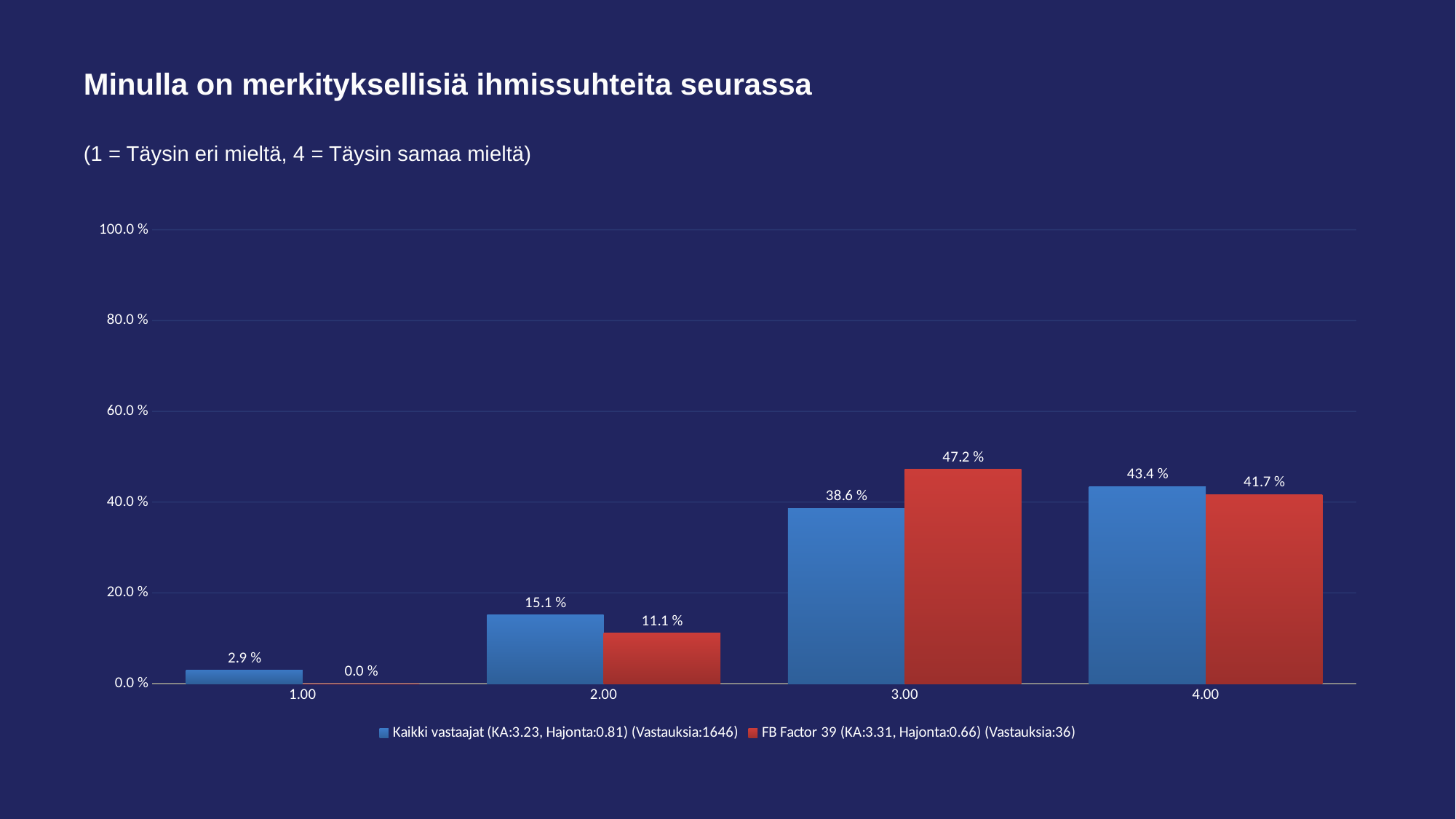
How many series does the legend list? 2 What is the value for FB Factor 39 at category 4.00? 41.7 % How many categories are shown on the x axis? 4 What is the value for Kaikki vastaajat at category 3.00? 38.6 % What is the value for FB Factor 39 at category 1.00? 0.0 % What is the value for Kaikki vastaajat at category 2.00? 15.1 % What kind of chart is shown on the slide? Bar chart Which category has the highest value for the FB Factor 39 series? 3.00 Is the value for Kaikki vastaajat at category 4.00 greater or less than 40.0 %? greater What is the difference between the FB Factor 39 and Kaikki vastaajat values at category 3.00? 8.6 % Which category has the lowest value for the Kaikki vastaajat series? 1.00 At category 2.00, which series has the larger value, Kaikki vastaajat or FB Factor 39? Kaikki vastaajat